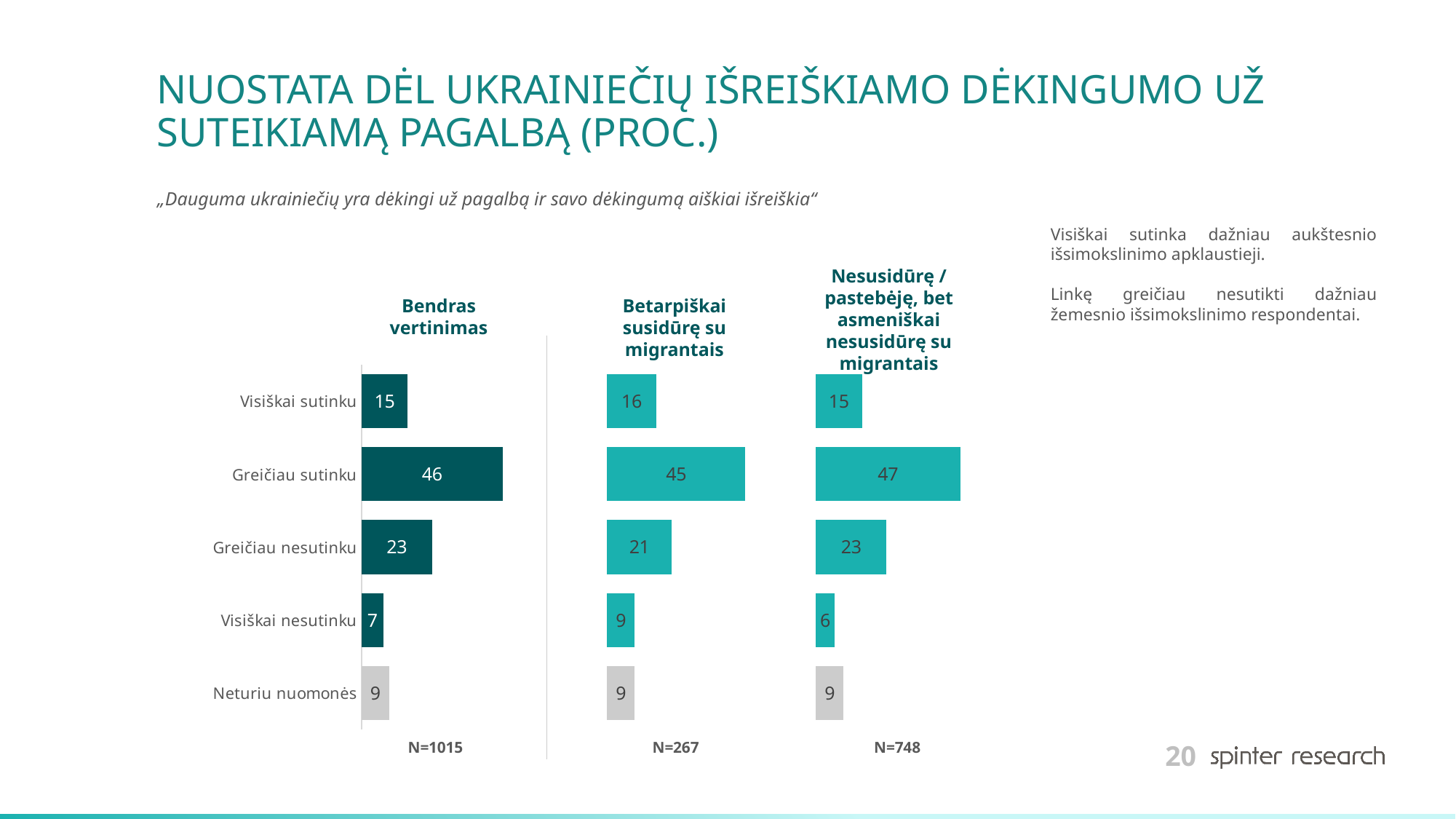
What is the sample size (N) shown under the "Betarpiškai susidūrę su migrantais" chart? N=267 What kind of chart is the "Bendras vertinimas" chart? Bar chart In the "Bendras vertinimas" chart, what is the value for "Greičiau sutinku"? 46 In the "Betarpiškai susidūrę su migrantais" chart, what is the difference between "Visiškai sutinku" and "Visiškai nesutinku"? 7 In the "Bendras vertinimas" chart, which category has the highest value? Greičiau sutinku In the "Betarpiškai susidūrę su migrantais" chart, what is the value for "Visiškai nesutinku"? 9 In the "Bendras vertinimas" chart, what colour is the "Neturiu nuomonės" bar? Grey Which is larger: "Greičiau sutinku" in the "Betarpiškai susidūrę su migrantais" chart or "Greičiau sutinku" in the "Nesusidūrę / pastebėję, bet asmeniškai nesusidūrę su migrantais" chart? Nesusidūrę / pastebėję, bet asmeniškai nesusidūrę su migrantais In the "Nesusidūrę / pastebėję, bet asmeniškai nesusidūrę su migrantais" chart, which category has the lowest value? Visiškai nesutinku How many categories does the "Bendras vertinimas" chart show? 5 In the "Nesusidūrę / pastebėję, bet asmeniškai nesusidūrę su migrantais" chart, what is the value for "Greičiau nesutinku"? 23 In the "Bendras vertinimas" chart, what is the difference between "Greičiau sutinku" and "Greičiau nesutinku"? 23